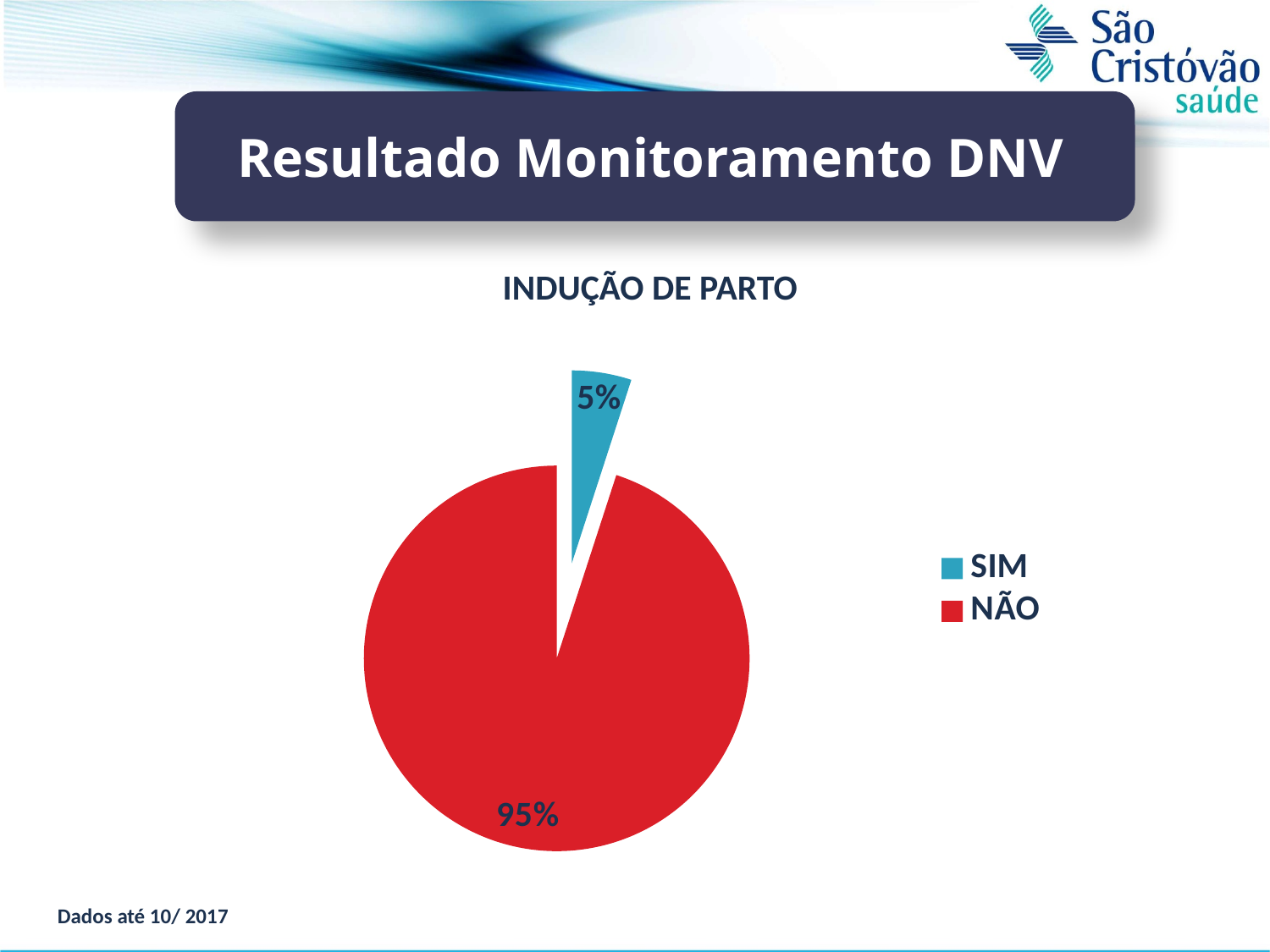
How many categories does the pie chart have? 2 Which is larger, the share for SIM or the share for NÃO? NÃO What kind of chart is shown on the slide? pie chart How many entries does the legend list? 2 What is the title of the chart? INDUÇÃO DE PARTO Which category has the largest slice of the pie? NÃO What colour is the slice for NÃO? red Is the share for NÃO greater or less than 50%? greater Which category has the smallest slice of the pie? SIM What is the difference in percentage points between NÃO and SIM? 90 What share of the pie does SIM represent? 5% What share of the pie does NÃO represent? 95%